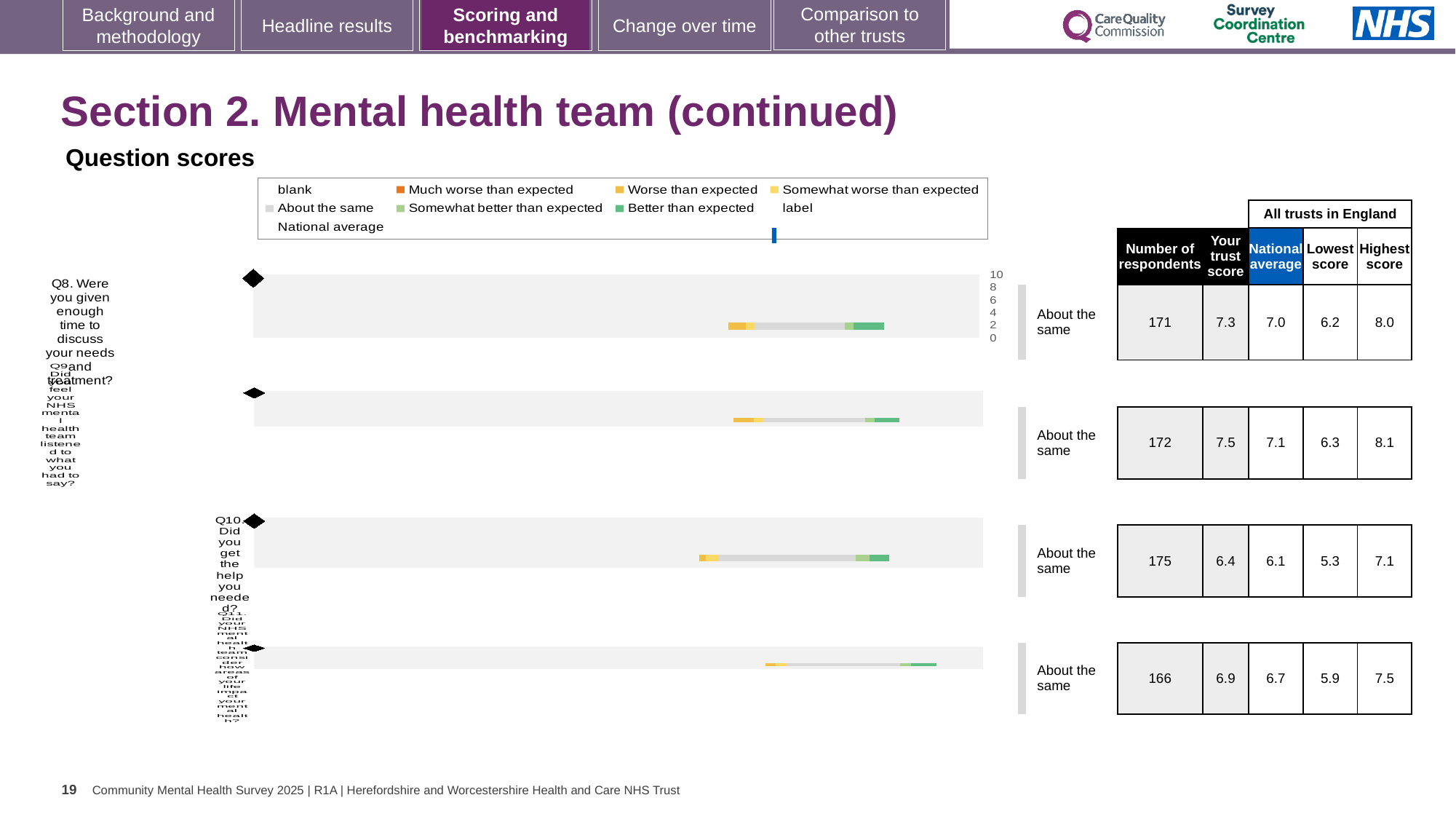
In the legend, what colour represents 'Much worse than expected'? orange What kind of chart is used to show the question scores on this slide? bar chart Which question has the lowest trust score on this slide? Q10 For Q10 (Did you get the help you needed?), what is the national average score? 6.1 Which question has the highest trust score on this slide? Q9 How many questions (Q8 to Q11) have a score chart on this slide? 4 For the bottom chart (Q11), what is the highest score among all trusts in England? 7.5 For Q8 (Were you given enough time to discuss your needs and treatment?), what is the trust score shown in the table? 7.3 For Q8, what is the difference between the trust score and the national average? 0.3 What benchmark category is shown next to the Q8 chart? About the same For Q9, which is larger: the trust score or the national average? the trust score For the second chart (Q9), how many respondents are listed? 172